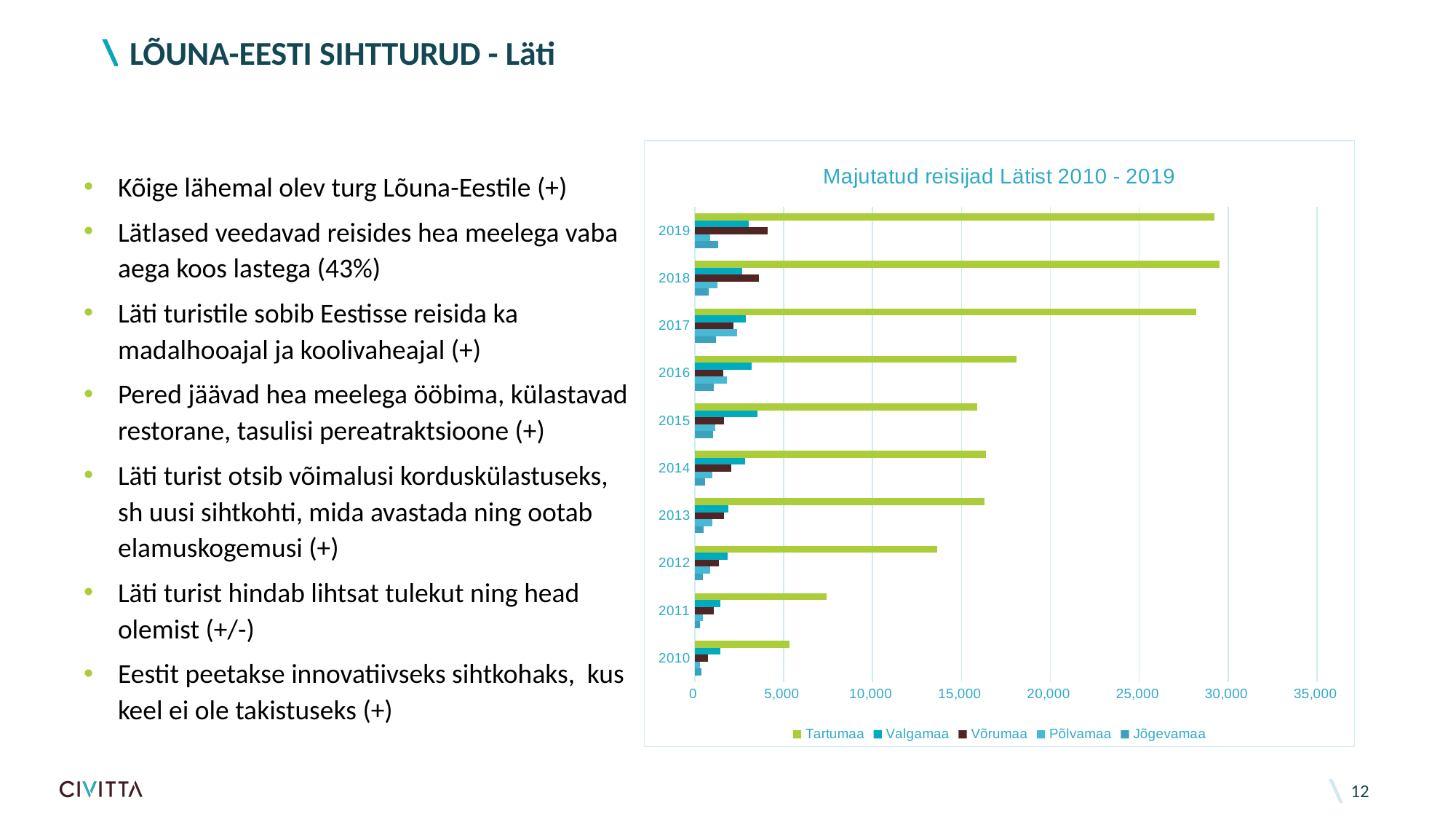
Is the Tartumaa value for 2016 greater or less than 15,000? greater Do the Tartumaa values generally rise or fall from 2010 to 2019? rise Is the Tartumaa value for 2017 greater or less than 25,000? greater Is the Tartumaa value for 2012 greater or less than 15,000? less Which series is listed first in the chart legend? Tartumaa How many series does the chart legend list? 5 In which year is the Tartumaa value lowest? 2010 What kind of chart is shown on the slide? bar chart How many years are shown on the chart's vertical axis? 10 What is the title of the chart? Majutatud reisijad Lätist 2010 - 2019 Which is larger, the Tartumaa value for 2017 or for 2016? 2017